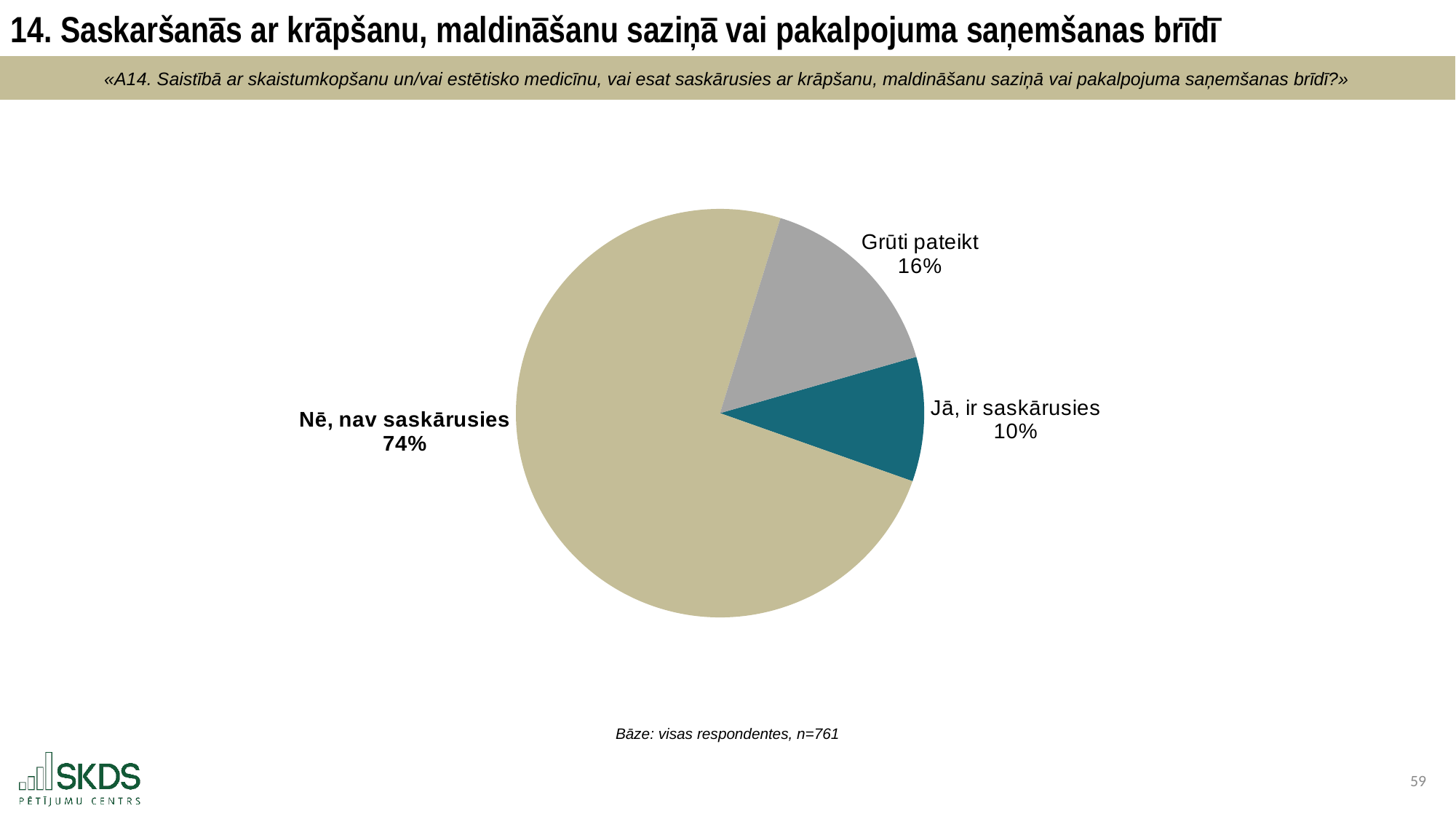
What percentage of respondents answered "Grūti pateikt"? 16% What is the difference in percentage points between "Grūti pateikt" and "Jā, ir saskārusies"? 6 What kind of chart is shown on the slide? pie chart What percentage of respondents answered "Nē, nav saskārusies"? 74% Which is larger: the share for "Grūti pateikt" or the share for "Jā, ir saskārusies"? Grūti pateikt What is the difference in percentage points between "Nē, nav saskārusies" and "Jā, ir saskārusies"? 64 Which answer category has the largest share of the pie? Nē, nav saskārusies Which slice of the pie is coloured dark teal? Jā, ir saskārusies How many slices does the pie chart have? 3 What is the base (number of respondents) stated below the chart? n=761 Which answer category has the smallest share of the pie? Jā, ir saskārusies What percentage of respondents answered "Jā, ir saskārusies"? 10%